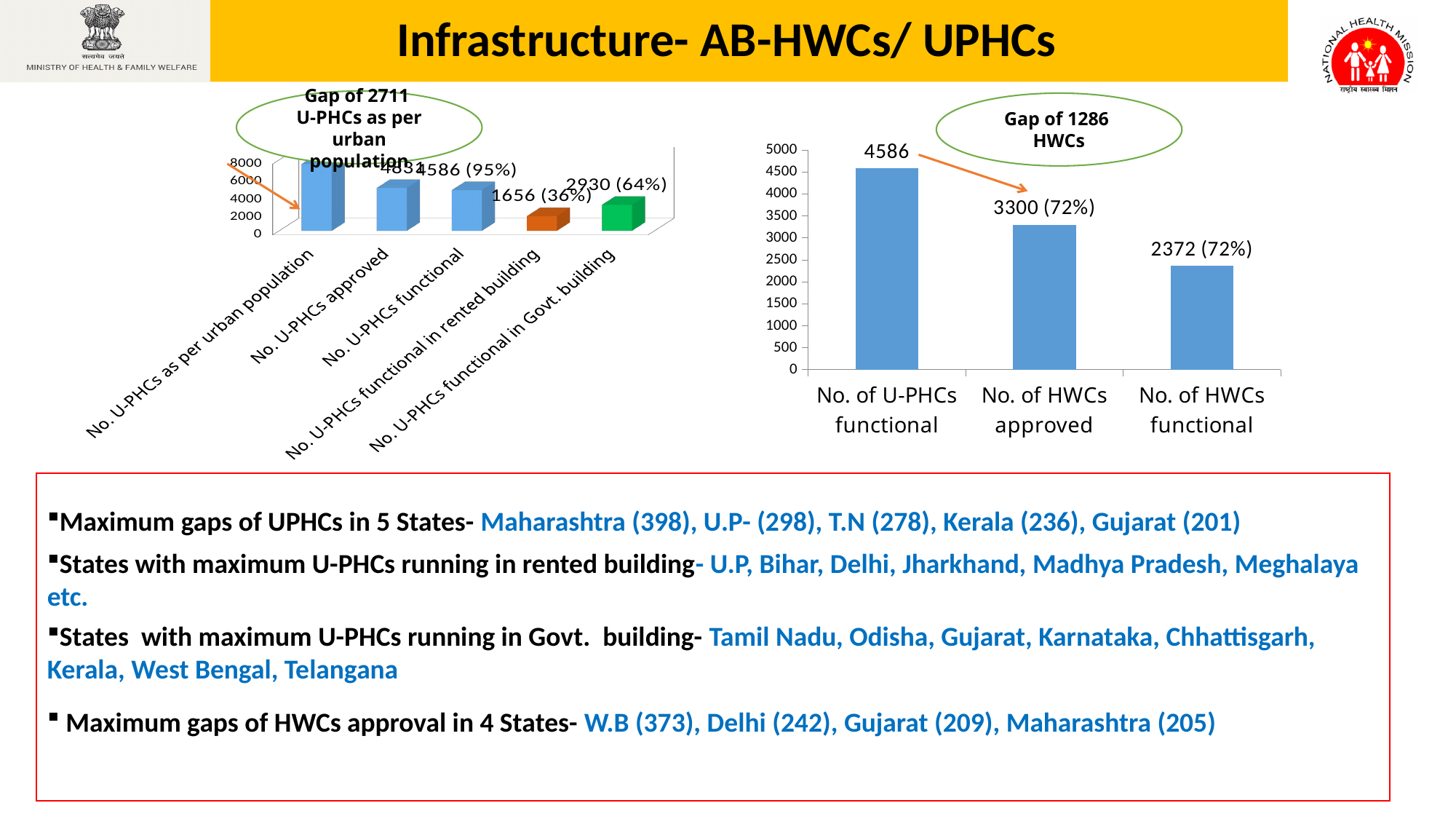
In the right-hand chart, what is the data label for No. of HWCs approved? 3300 (72%) In the right-hand chart, what is the difference between No. of U-PHCs functional and No. of HWCs approved? 1286 In the right-hand chart, how many categories are plotted? 3 In the right-hand chart, which category has the lowest value? No. of HWCs functional In the left-hand chart, how many categories are plotted? 5 In the left-hand chart, is the value for No. U-PHCs as per urban population greater or less than 6000? greater In the right-hand chart, do the values rise or fall from left to right? fall In the left-hand chart, what is the data label for No. U-PHCs functional in rented building? 1656 (36%) In the right-hand chart, what is the data label for No. of HWCs functional? 2372 (72%) In the right-hand chart, what is the value for No. of U-PHCs functional? 4586 In the left-hand chart, which is larger: No. U-PHCs functional in rented building or No. U-PHCs functional in Govt. building? No. U-PHCs functional in Govt. building In the left-hand chart, what is the data label for No. U-PHCs functional in Govt. building? 2930 (64%)